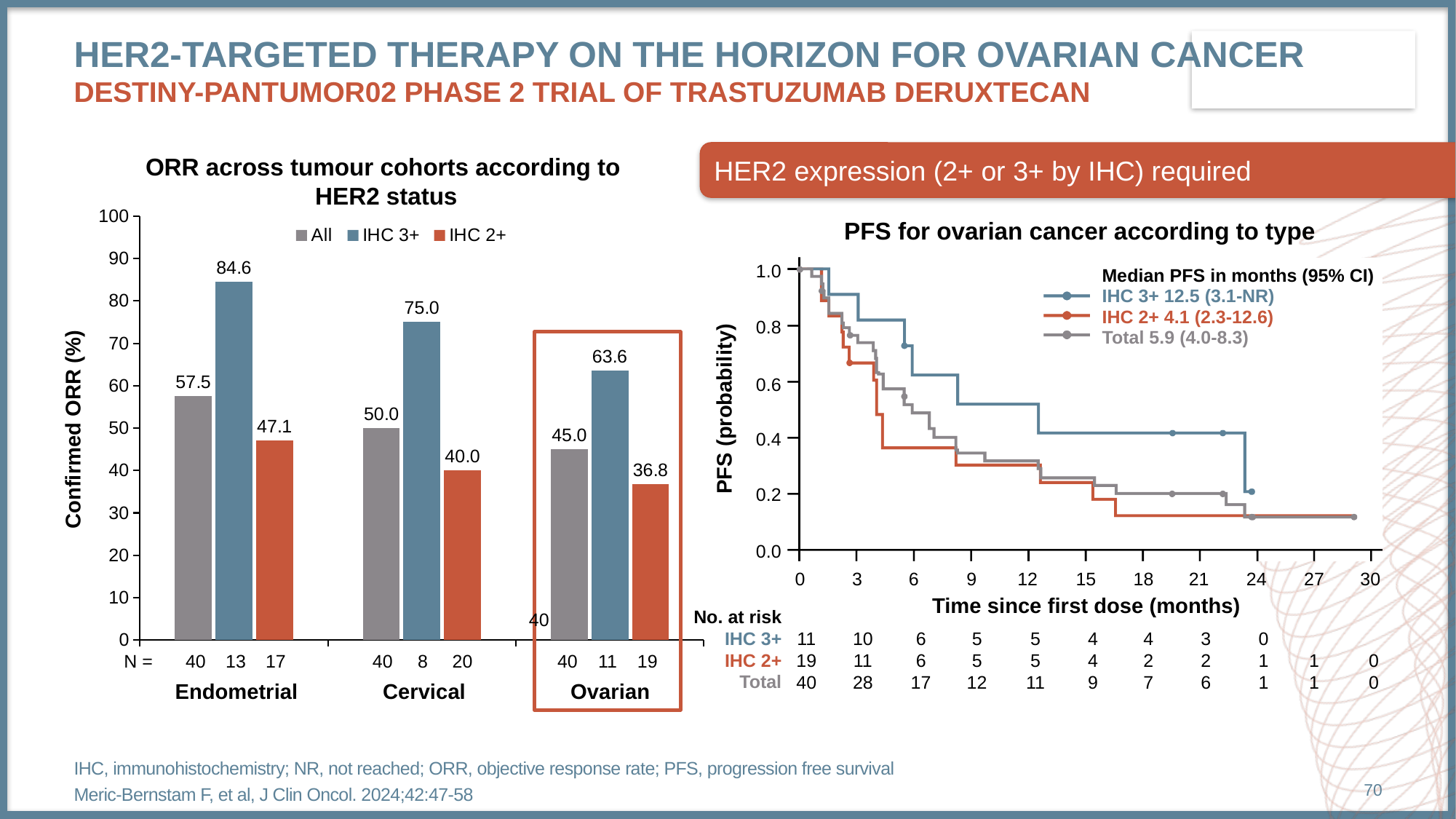
What kind of chart is the ORR across tumour cohorts chart? Bar chart In the ORR across tumour cohorts chart, which bar has the lowest value overall? IHC 2+ in Ovarian (36.8) How many tumour cohorts are shown in the ORR across tumour cohorts chart? 3 In the PFS for ovarian cancer chart, what is the median PFS in months for IHC 3+? 12.5 (3.1-NR) In the ORR across tumour cohorts chart, what is the confirmed ORR for IHC 2+ in the Cervical cohort? 40.0 In the ORR across tumour cohorts chart, which is larger: the 'All' ORR for Cervical or the 'All' ORR for Ovarian? Cervical In the ORR across tumour cohorts chart, which tumour cohort has the highest IHC 3+ ORR? Endometrial In the ORR across tumour cohorts chart, what is the difference between the IHC 3+ and IHC 2+ ORR in the Endometrial cohort? 37.5 In the ORR across tumour cohorts chart, what is the difference between the IHC 3+ and IHC 2+ ORR in the Ovarian cohort? 26.8 How many series does the legend of the ORR across tumour cohorts chart list? 3 In the PFS for ovarian cancer chart, do the PFS curves rise or fall as time since first dose increases? Fall In the ORR across tumour cohorts chart, what is the confirmed ORR for IHC 3+ in the Ovarian cohort? 63.6